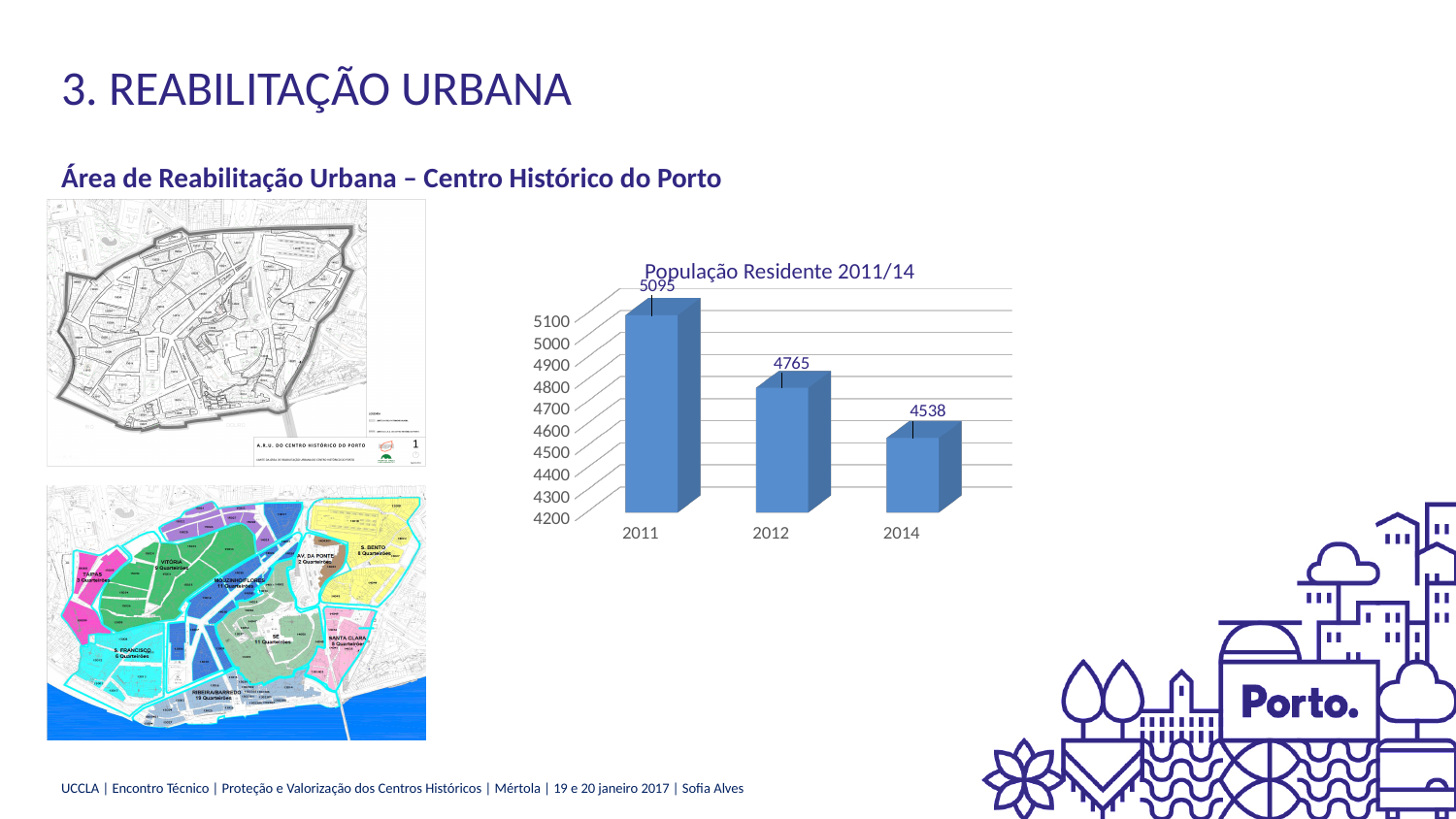
What is the title of the chart on the slide? População Residente 2011/14 Do the values rise or fall from 2011 to 2014? fall Which year has the highest resident population? 2011 What is the resident population value for 2014? 4538 How many years are shown on the x axis of the chart? 3 What is the difference between the 2012 and 2014 values? 227 What type of chart is shown on the slide? bar chart What is the difference between the 2011 and 2014 values? 557 Which is larger, the value for 2012 or the value for 2014? 2012 Which year has the lowest resident population? 2014 What is the resident population value for 2012? 4765 What is the resident population value for 2011? 5095